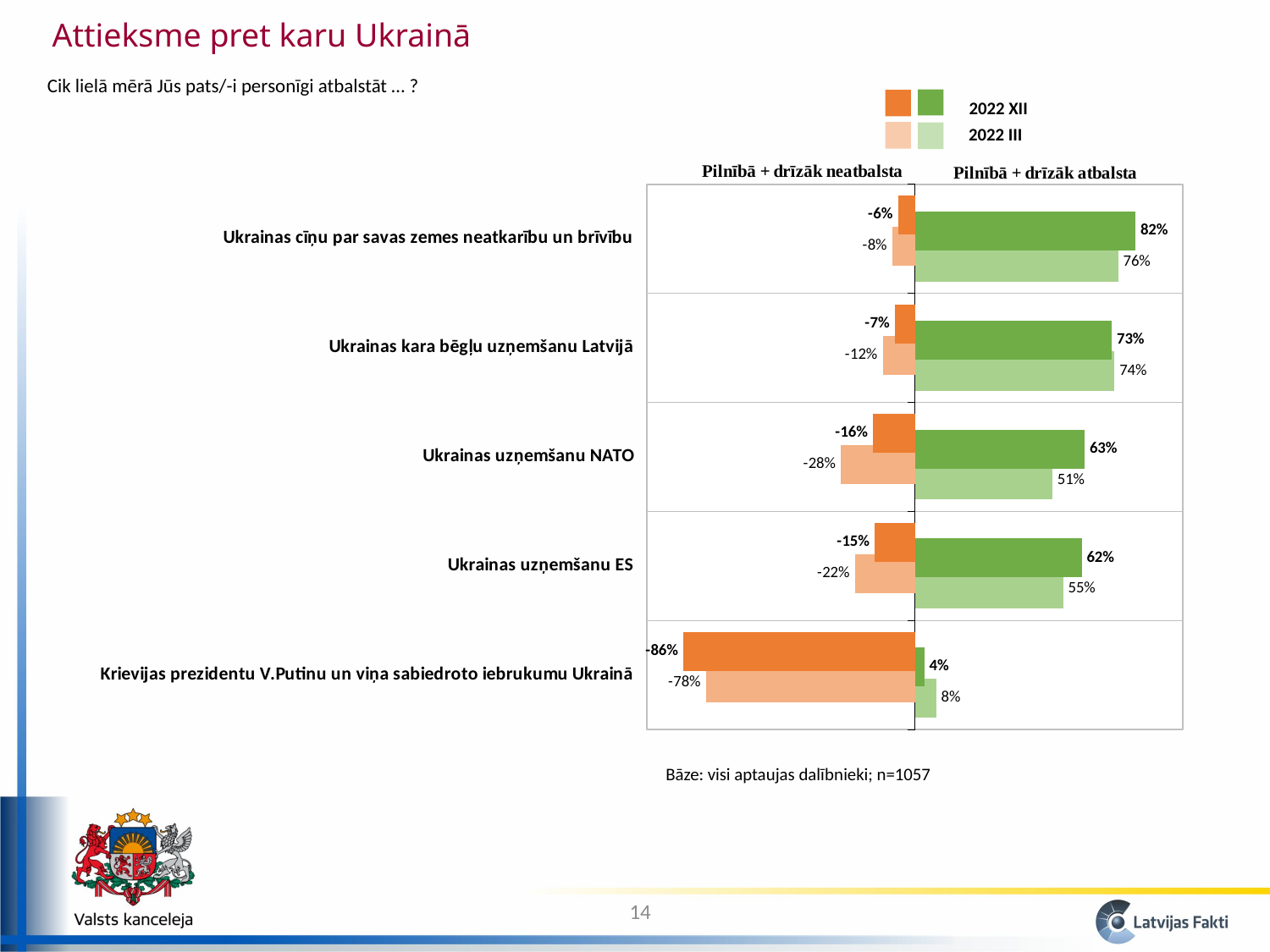
What is the base (n) stated below the chart? n=1057 How many categories (statements) are shown in the chart? 5 What is the 2022 XII value for "Pilnībā + drīzāk atbalsta" for "Krievijas prezidentu V.Putinu un viņa sabiedroto iebrukumu Ukrainā"? 4% For "Ukrainas uzņemšanu ES", which period has the larger "Pilnībā + drīzāk atbalsta" value, 2022 XII or 2022 III? 2022 XII What is the 2022 XII value for "Pilnībā + drīzāk atbalsta" for "Ukrainas cīņu par savas zemes neatkarību un brīvību"? 82% What is the difference between the 2022 XII and 2022 III "Pilnībā + drīzāk atbalsta" values for "Ukrainas uzņemšanu NATO"? 12 percentage points What is the 2022 III value for "Pilnībā + drīzāk atbalsta" for "Ukrainas kara bēgļu uzņemšanu Latvijā"? 74% What is the 2022 III value for "Pilnībā + drīzāk neatbalsta" for "Ukrainas uzņemšanu NATO"? -28% Which category has the highest 2022 XII "Pilnībā + drīzāk atbalsta" value? Ukrainas cīņu par savas zemes neatkarību un brīvību How many periods does the legend list? 2 Which category has the lowest 2022 XII "Pilnībā + drīzāk atbalsta" value? Krievijas prezidentu V.Putinu un viņa sabiedroto iebrukumu Ukrainā What type of chart is shown on the slide? Bar chart